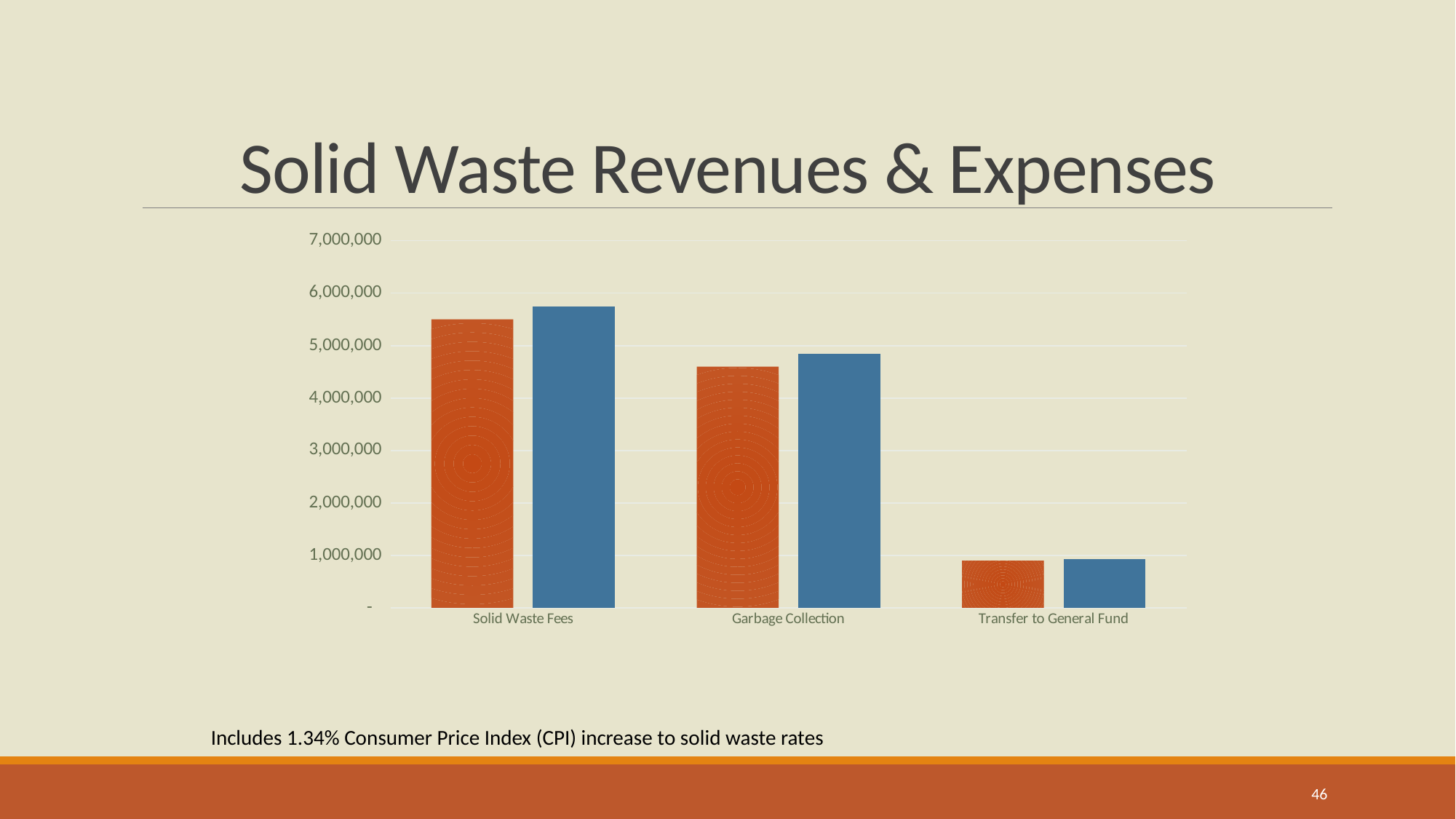
What is the title of the slide containing the chart? Solid Waste Revenues & Expenses What kind of chart is shown on the slide? bar chart Is the orange bar for Transfer to General Fund greater or less than 1,000,000? less Which category has the tallest bars in the chart? Solid Waste Fees How many bars are shown for each category in the chart? 2 Do the bar heights rise or fall moving from left to right across the categories? fall How many categories are shown on the x axis of the chart? 3 Is the blue bar for Garbage Collection greater or less than 5,000,000? less Which is larger, the orange bar for Solid Waste Fees or the orange bar for Garbage Collection? Solid Waste Fees Which category has the shortest bars in the chart? Transfer to General Fund Is the orange bar for Solid Waste Fees greater or less than 5,000,000? greater